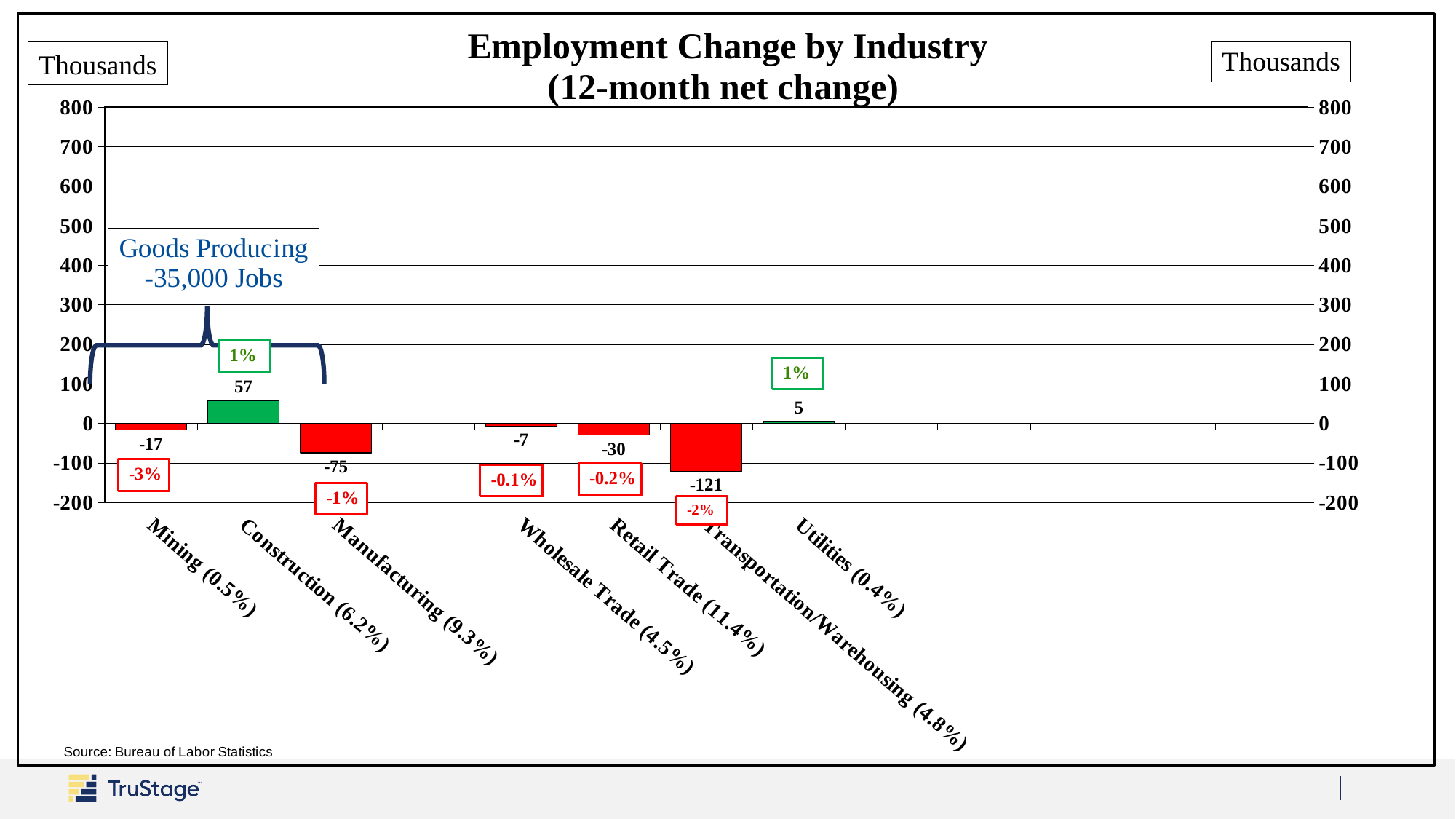
What is the 12-month net employment change for Transportation/Warehousing, in thousands? -121 According to the callout on the chart, how many jobs did the Goods Producing sector lose? 35,000 What kind of chart is shown on the slide? Bar chart What is the 12-month net employment change for Utilities, in thousands? 5 Which has a larger net employment loss, Retail Trade or Wholesale Trade? Retail Trade What percentage change is shown in the box above the Construction bar? 1% Which industry has the largest 12-month net employment gain? Construction What is the difference between the net employment change for Construction and for Manufacturing, in thousands? 132 What is the 12-month net employment change for Construction, in thousands? 57 Which industry has the largest 12-month net employment loss? Transportation/Warehousing What is the 12-month net employment change for Manufacturing, in thousands? -75 How many industries are labeled on the x axis of the chart? 7